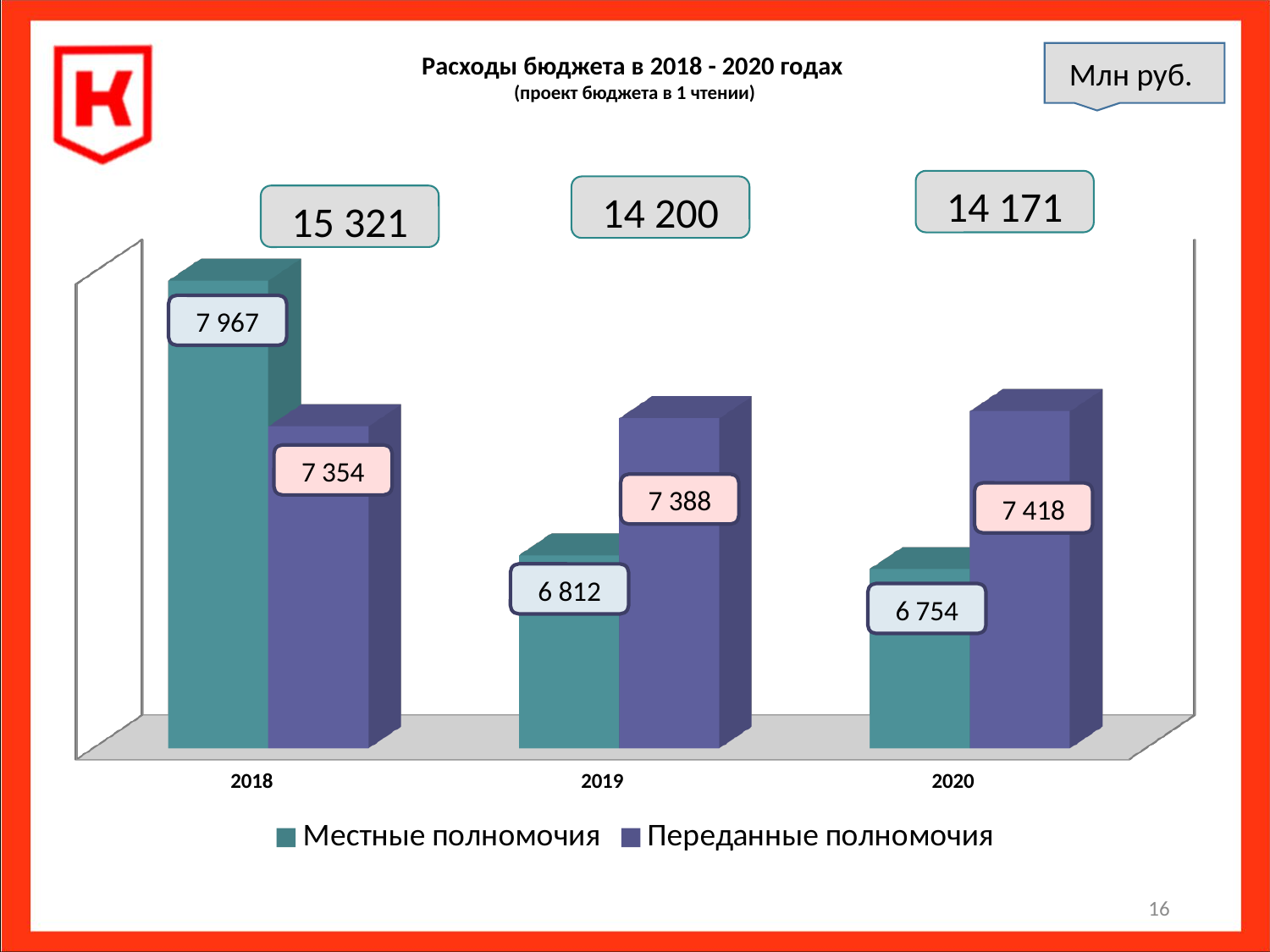
Which is larger in 2020: Местные полномочия or Переданные полномочия? Переданные полномочия In which year is the value for Местные полномочия the lowest? 2020 What is the difference between Местные полномочия and Переданные полномочия in 2019? 576 In which year is the value for Местные полномочия the highest? 2018 What is the value for Местные полномочия in 2019? 6 812 Does the value for Местные полномочия rise or fall from 2018 to 2020? Fall What is the value for Переданные полномочия in 2020? 7 418 What is the value for Местные полномочия in 2018? 7 967 What is the value for Переданные полномочия in 2018? 7 354 What kind of chart is shown on the slide? Bar chart How many years are shown on the x axis? 3 How many series does the legend list? 2